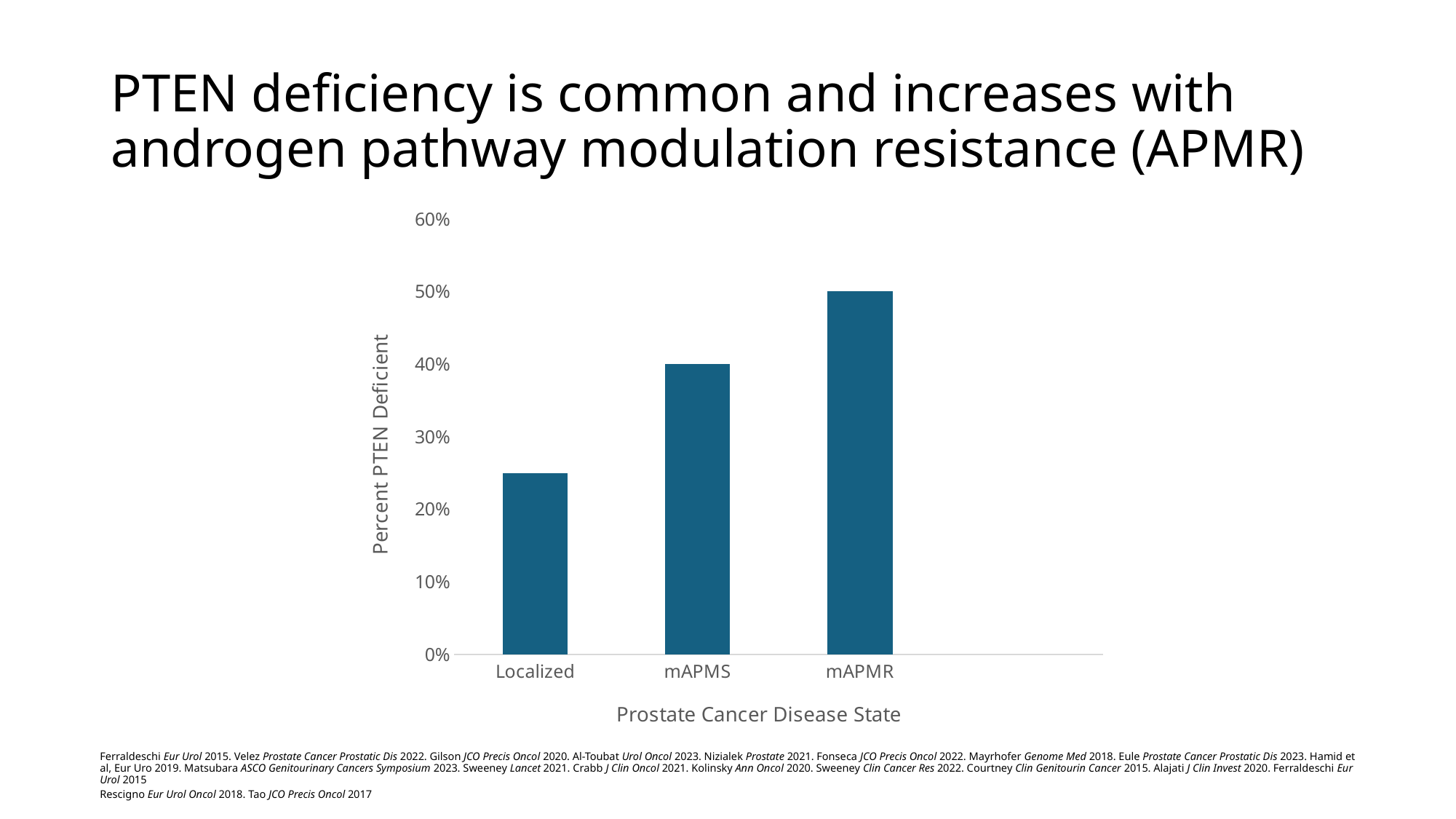
How many disease state categories are plotted on the x axis? 3 Which disease state has the lowest percent PTEN deficient? Localized What is the label of the y axis? Percent PTEN Deficient What is the percent PTEN deficient for mAPMS? 40% Which disease state has the highest percent PTEN deficient? mAPMR What is the difference in percent PTEN deficient between mAPMR and mAPMS? 10% What is the percent PTEN deficient for mAPMR? 50% Which has a higher percent PTEN deficient, Localized or mAPMS? mAPMS Do the values rise or fall moving from Localized to mAPMR along the x axis? rise Is the percent PTEN deficient for Localized greater or less than 30%? less Is the percent PTEN deficient for Localized greater or less than 20%? greater What type of chart is shown on the slide? bar chart